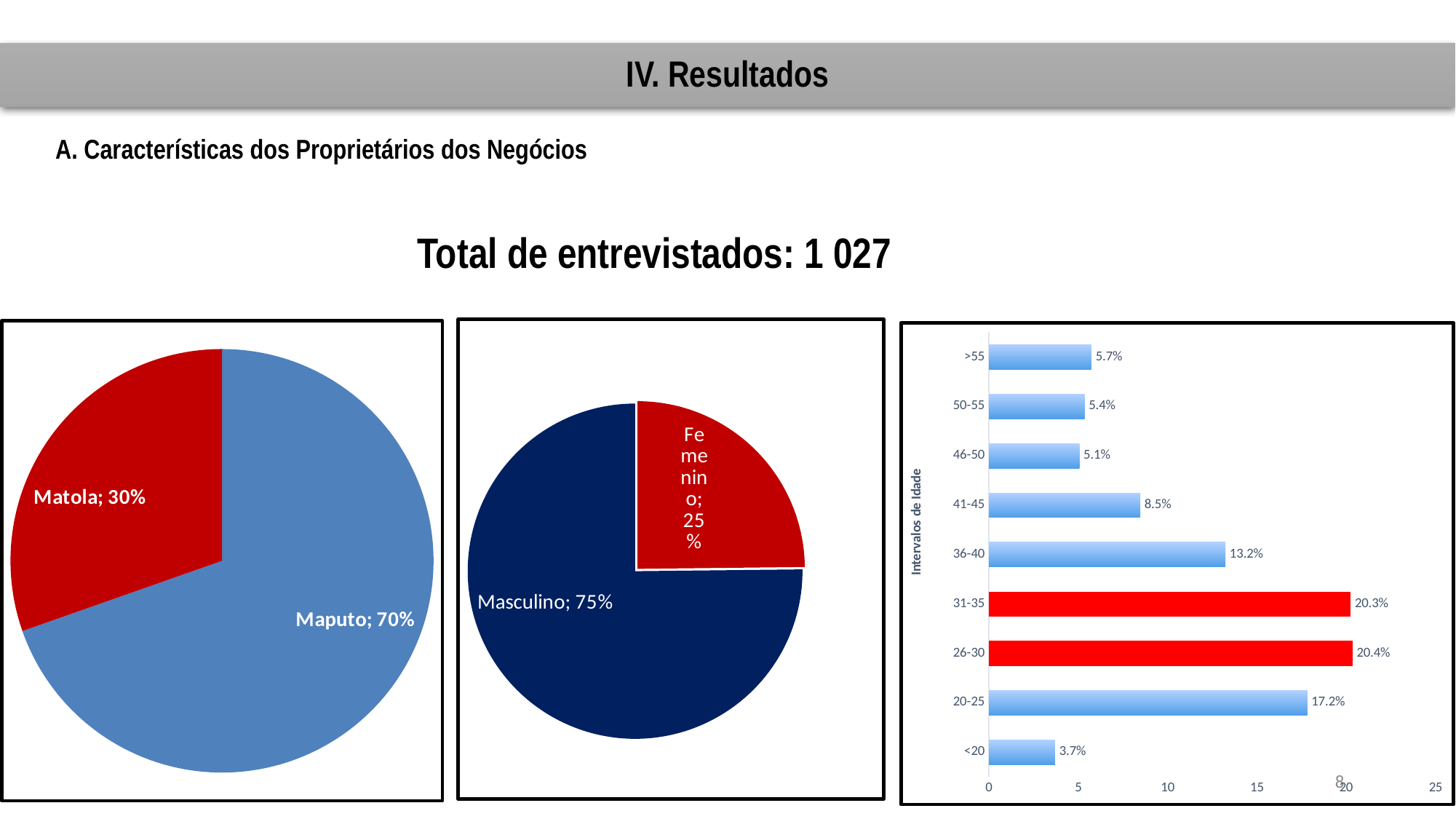
In the left pie chart, which slice is larger, Maputo or Matola? Maputo In the bar chart on the right, what is the difference between the values for 20-25 and 41-45? 8.7% In the bar chart on the right, which age interval has the lowest value? <20 In the bar chart on the right, what is the value for the 36-40 age interval? 13.2% What kind of chart is the chart on the right of the slide? Bar chart In the left pie chart, what share is labelled for Matola? 30% In the left pie chart, what share is labelled for Maputo? 70% In the middle pie chart, what share is labelled for Feminino? 25% In the middle pie chart, what share is labelled for Masculino? 75% In the middle pie chart, what is the difference between the Masculino and Feminino shares? 50% In the bar chart on the right, how many age intervals are shown? 9 In the bar chart on the right, what is the label of the vertical axis? Intervalos de Idade